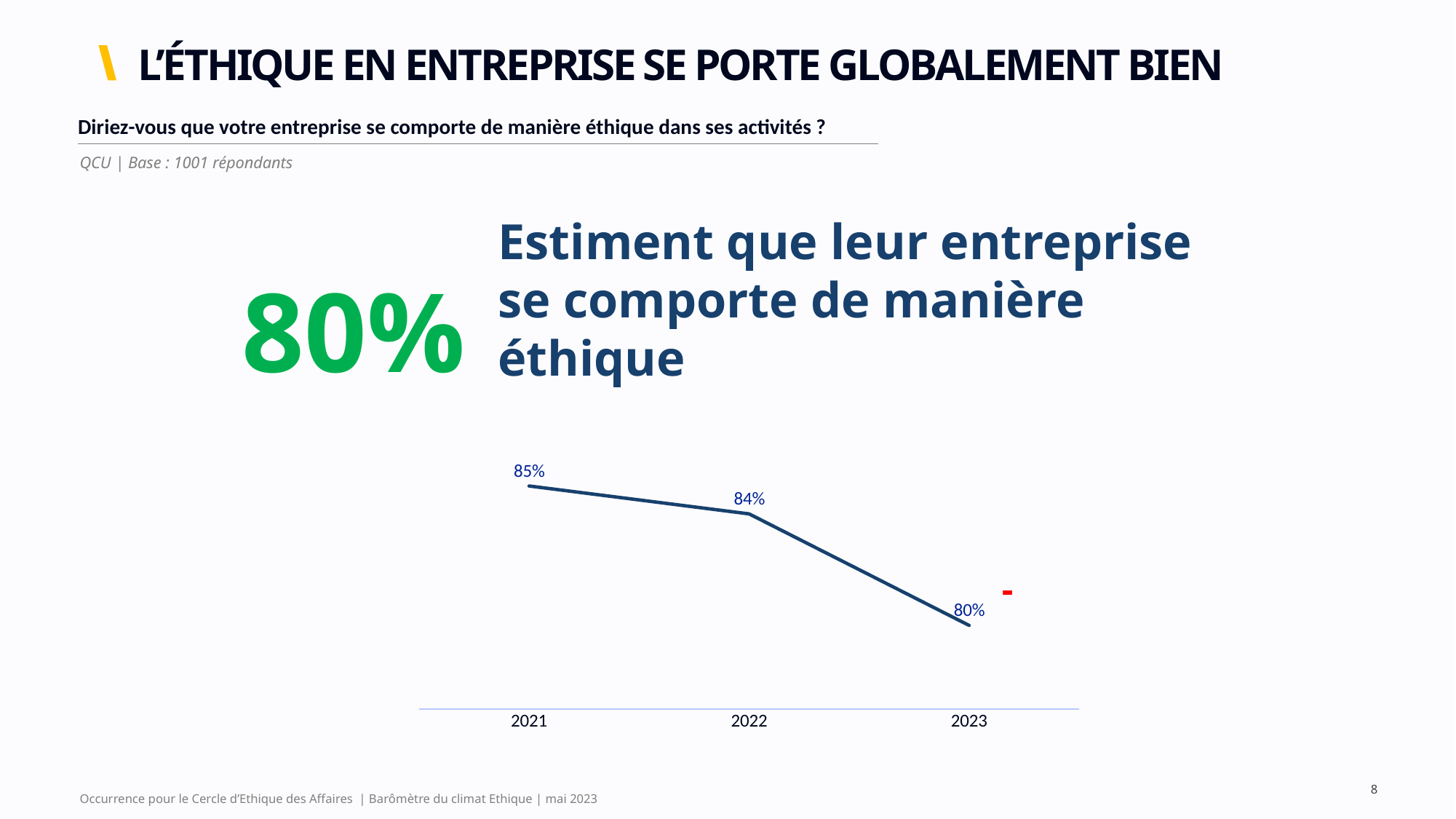
How many years are plotted on the chart? 3 What is the value for 2022? 84% Do the values rise or fall from 2021 to 2023? Fall What is the value for 2021? 85% What is the large green figure highlighted on the slide? 80% Which is larger, the value for 2021 or the value for 2023? 2021 What is the difference between the values for 2022 and 2023? 4 percentage points What kind of chart is shown on the slide? Line chart What is the value for 2023? 80% Which year has the lowest value? 2023 What is the difference between the values for 2021 and 2023? 5 percentage points Which year has the highest value? 2021